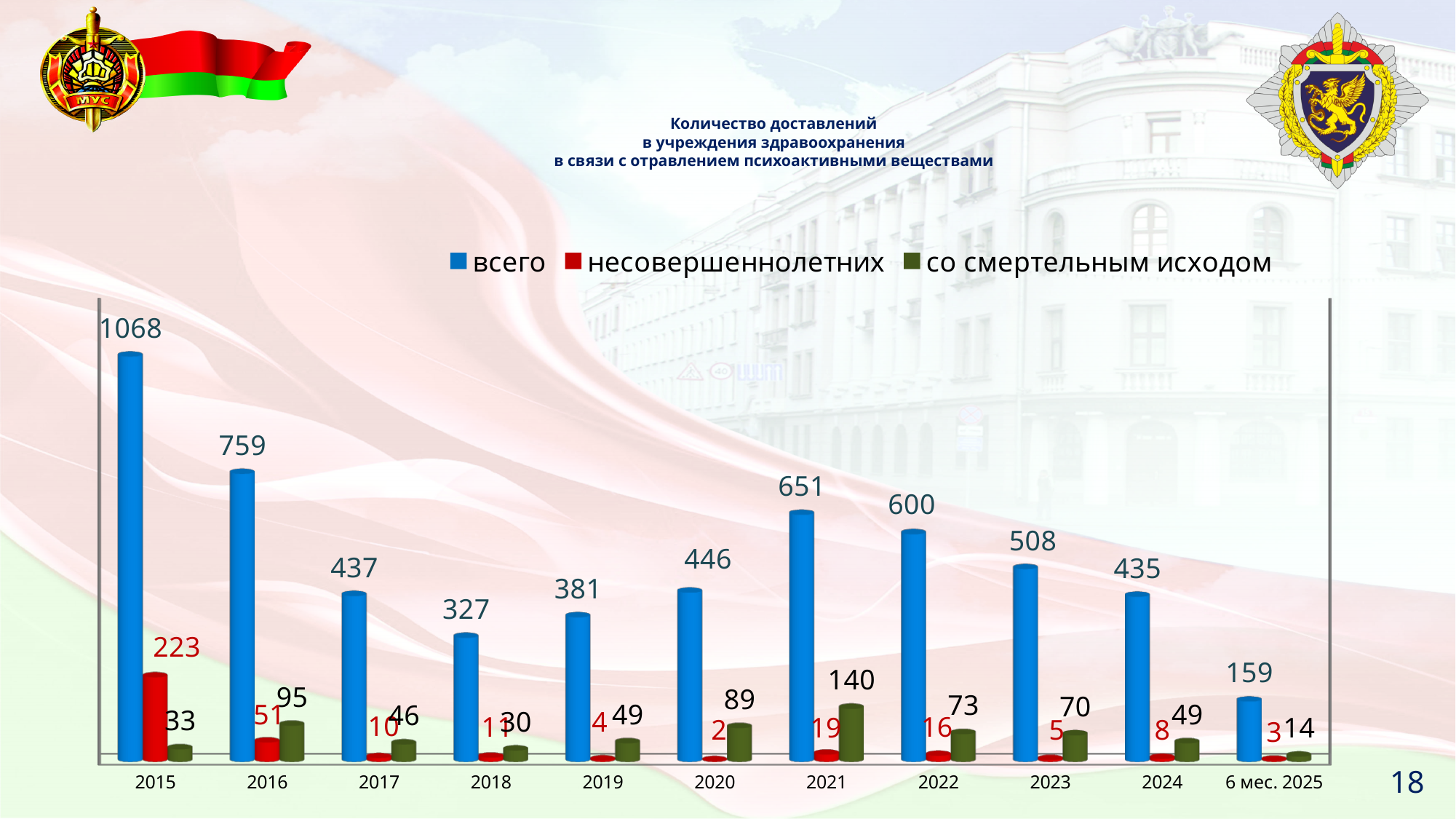
What is the difference between the "всего" values for 2021 and 2022? 51 Which colour represents the "несовершеннолетних" series? red Which year has the highest value in the "всего" series? 2015 What kind of chart is shown on the slide? bar chart What is the value of the "всего" series for 2015? 1068 How many series does the legend list? 3 What is the value of the "всего" series for "6 мес. 2025"? 159 Which is larger: the "со смертельным исходом" value for 2020 or for 2022? 2020 How many categories are shown on the x axis? 11 What is the value of the "со смертельным исходом" series for 2021? 140 Which category has the lowest value in the "со смертельным исходом" series? 6 мес. 2025 What is the value of the "несовершеннолетних" series for 2016? 51